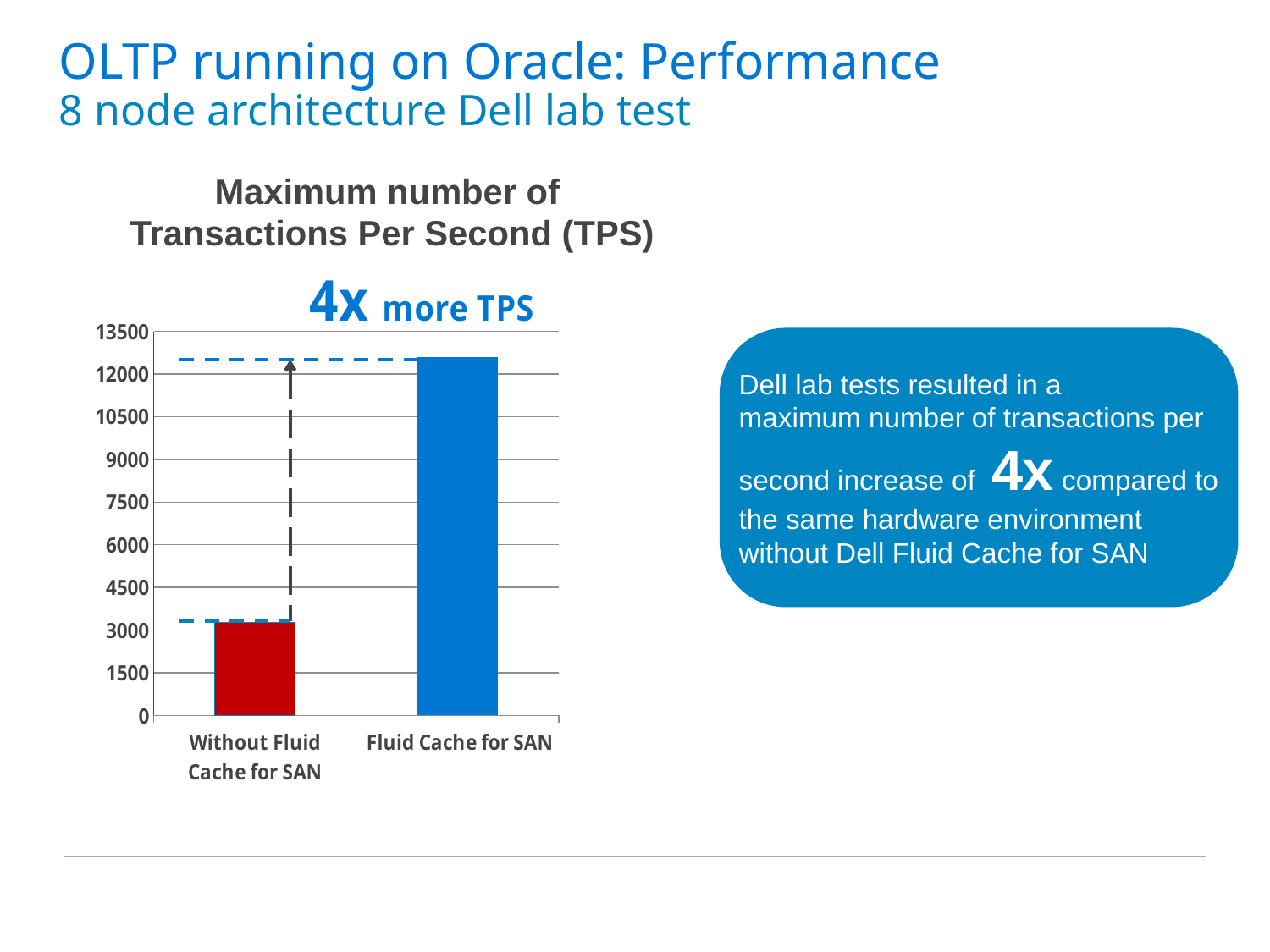
Which is larger, the value for Fluid Cache for SAN or the value for Without Fluid Cache for SAN? Fluid Cache for SAN Which category has the lowest maximum number of transactions per second? Without Fluid Cache for SAN Is the value for Fluid Cache for SAN greater or less than 13500? less Do the values rise or fall moving from left to right along the x axis? rise How many categories are plotted in the chart? 2 Is the value for Without Fluid Cache for SAN greater or less than 1500? greater Is the value for Without Fluid Cache for SAN greater or less than 4500? less Which category has the highest maximum number of transactions per second? Fluid Cache for SAN What is the title of the chart? Maximum number of Transactions Per Second (TPS) What colour is the bar for Fluid Cache for SAN? blue What kind of chart is shown on the slide? bar chart